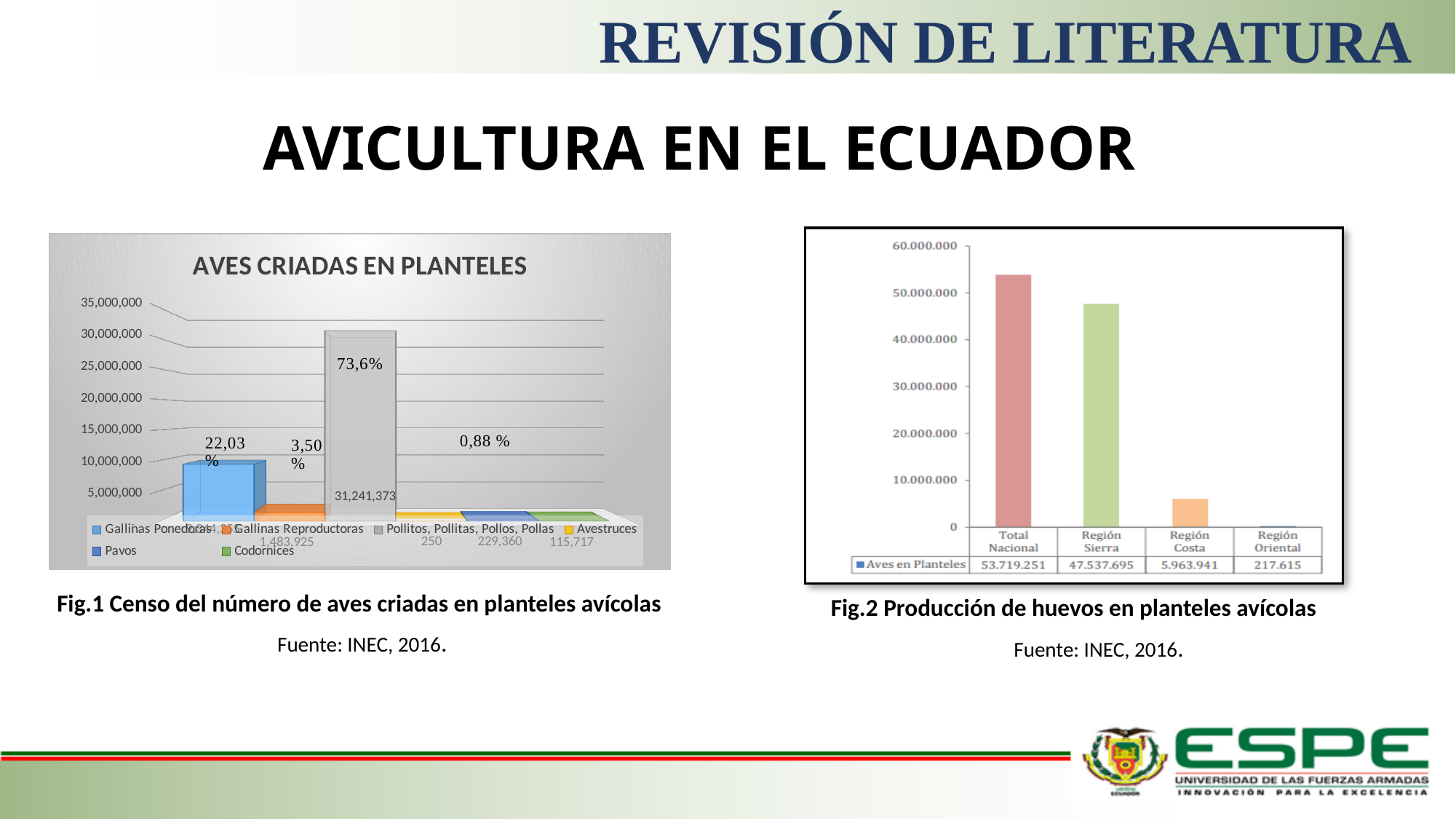
In the chart titled 'AVES CRIADAS EN PLANTELES', what is the value for Pollitos, Pollitas, Pollos, Pollas? 31,241,373 In the chart on the right (Fig.2), what is the difference between Total Nacional and Región Sierra? 6.181.556 In the chart titled 'AVES CRIADAS EN PLANTELES', what is the value for Gallinas Reproductoras? 1,483,925 In the chart on the right (Fig.2), what is the value for Región Sierra? 47.537.695 In the chart on the right (Fig.2), which region has the lowest value? Región Oriental In the chart on the right (Fig.2), what is the value for Región Oriental? 217.615 How many entries does the legend of the chart titled 'AVES CRIADAS EN PLANTELES' list? 6 What kind of chart is the chart on the right (Fig.2)? bar chart In the chart on the right (Fig.2), which is larger, Región Sierra or Región Costa? Región Sierra In the chart on the right (Fig.2), how many categories are shown on the x axis? 4 In the chart on the right (Fig.2), what is the value for Región Costa? 5.963.941 In the chart on the right (Fig.2), what is the value for Total Nacional? 53.719.251